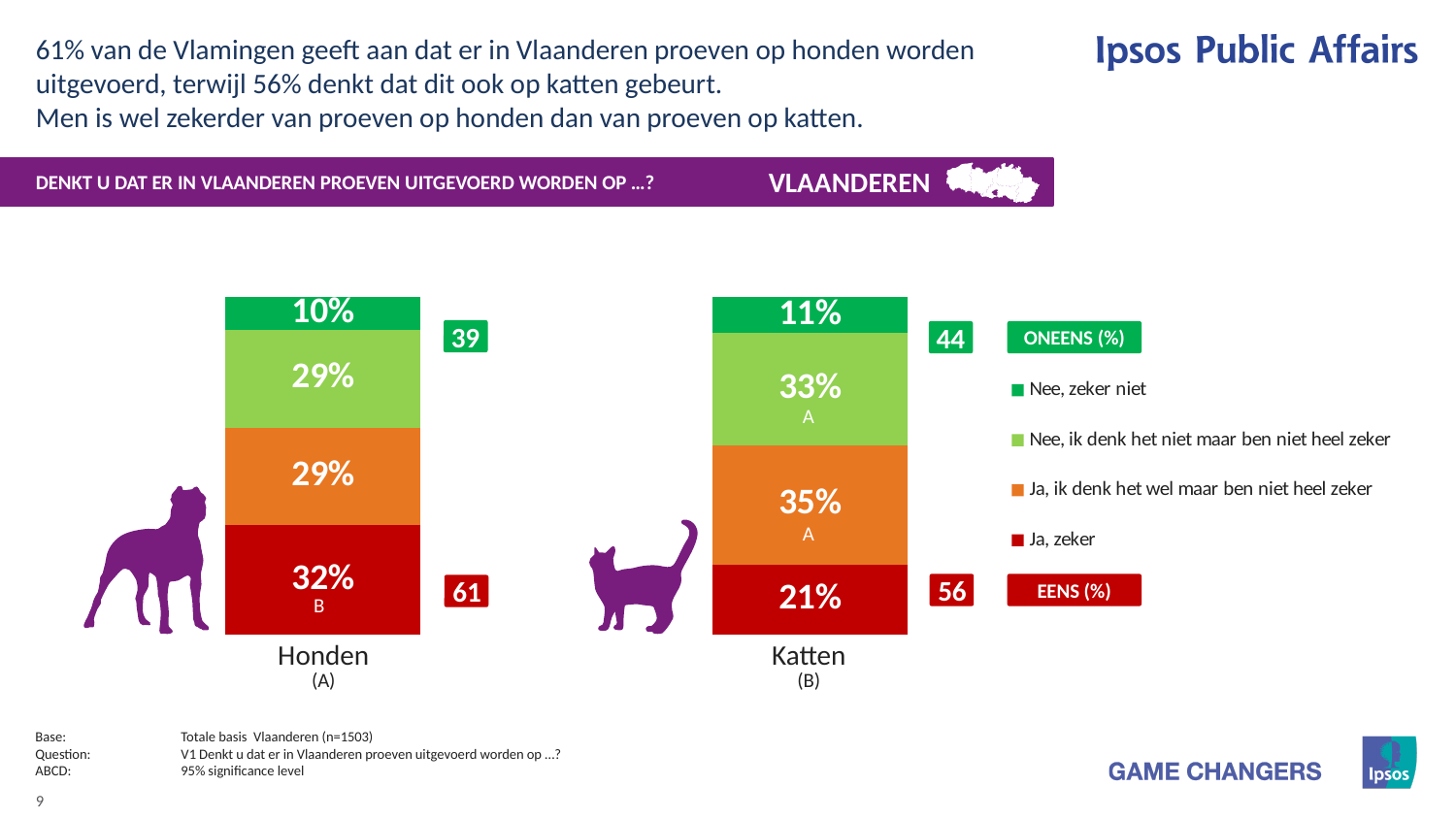
What is the value of 'Ja, zeker' for Katten? 21% Which colour represents 'Ja, zeker' in the legend? Red How many categories are plotted on the x axis? 2 What is the ONEENS (%) total shown for Katten? 44 What is the EENS (%) total shown for Honden? 61 How many series does the legend list? 4 Which category has the larger 'Nee, ik denk het niet maar ben niet heel zeker' value, Honden or Katten? Katten What is the value of 'Ja, ik denk het wel maar ben niet heel zeker' for Katten? 35% What is the value of 'Ja, zeker' for Honden? 32% What is the difference between the 'Ja, zeker' values for Honden and Katten? 11% What kind of chart is shown on the slide? Stacked bar chart What is the value of 'Nee, zeker niet' for Katten? 11%